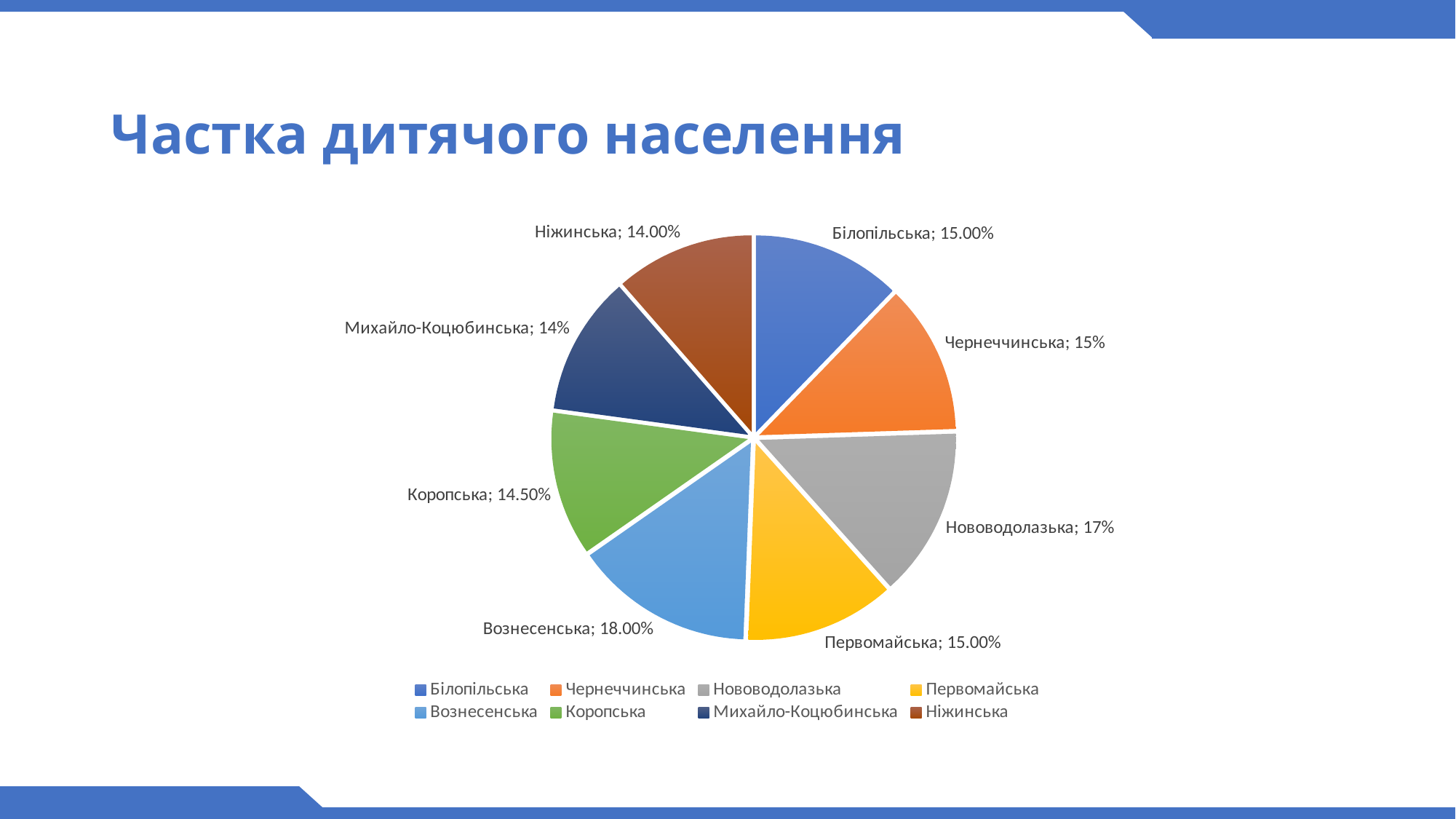
What value is shown for Білопільська? 15.00% How many categories (slices) does the pie chart have? 8 What value is shown for Коропська? 14.50% What is the title of the chart? Частка дитячого населення What is the difference between the values for Вознесенська and Нововодолазька? 1% How many entries does the legend list? 8 Which has a larger value, Нововодолазька or Коропська? Нововодолазька What type of chart is shown on the slide? pie chart Which category has the highest value? Вознесенська What value is shown for Михайло-Коцюбинська? 14% What value is shown for Нововодолазька? 17% What value is shown for Вознесенська? 18.00%